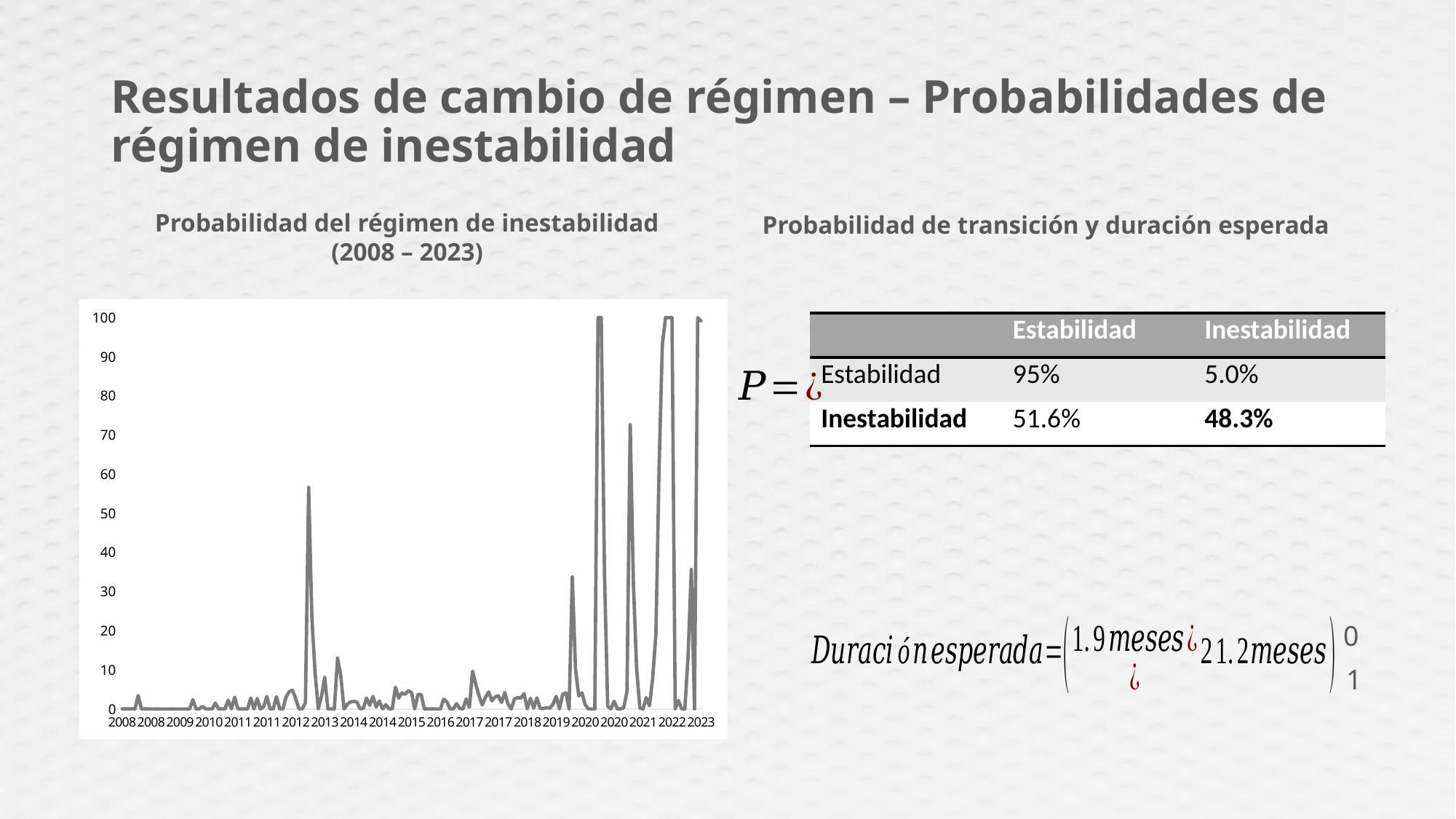
In the line chart, is the peak value reached around 2019 greater or less than 40? less In the line chart, is the peak value reached around 2019 greater or less than 30? greater In the line chart, is the peak value reached around 2021 greater or less than 60? greater What is the highest value shown on the y axis of the line chart? 100 In the line chart, which is higher: the peak around 2012 or the peak around 2020? the peak around 2020 How many lines (series) are plotted in the line chart? 1 What kind of chart is shown on the left of the slide? line chart In the line chart, which is higher: the peak around 2019 or the peak around 2021? the peak around 2021 What is the title of the chart on the left of the slide? Probabilidad del régimen de inestabilidad (2008 – 2023)